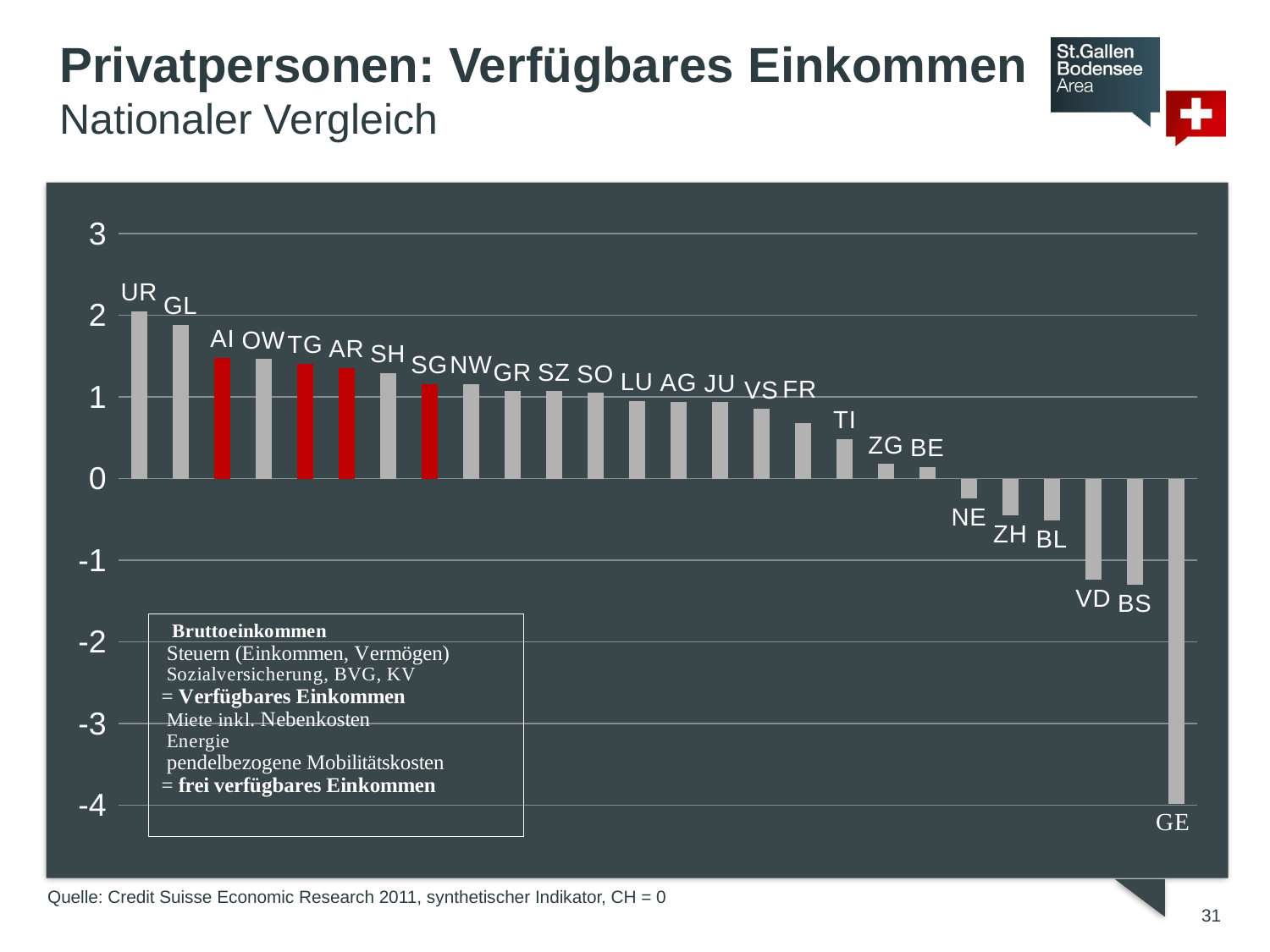
How many bars are highlighted in red? 4 Is the value for AI greater or less than 1? greater Which canton has the lowest value in the chart? GE Which canton has the highest value in the chart? UR Do the values rise or fall moving from left to right along the x axis? fall Which has the larger value, AI or TI? AI Is the value for VD greater or less than -1? less Is the value for TI greater or less than 1? less What kind of chart is shown on the slide? bar chart How many cantons (bars) are shown in the chart? 26